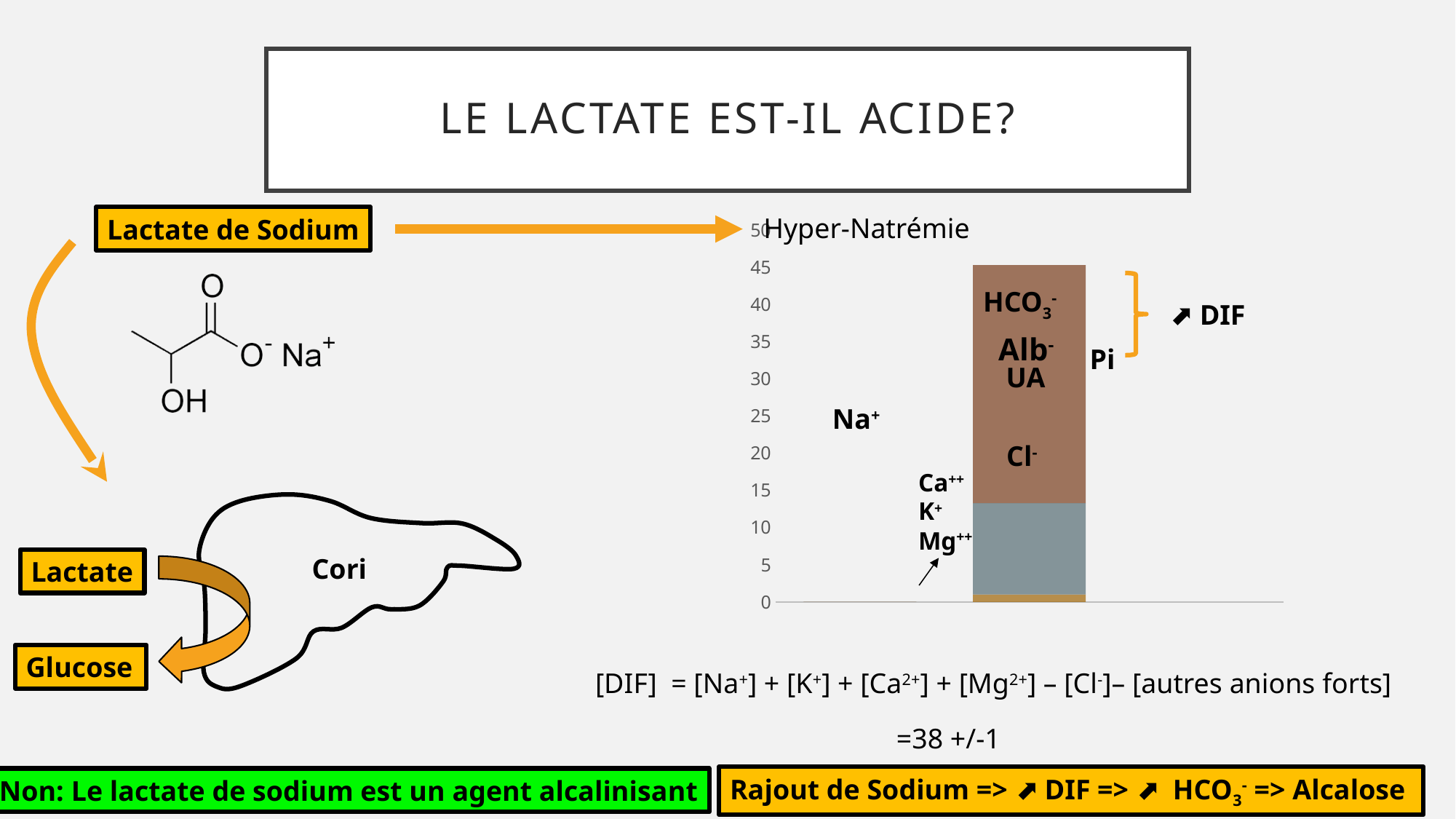
How many stacked segments make up the bar in the chart? 3 Is the top of the small bottom segment of the bar greater or less than 5? less What kind of chart is shown on the right side of the slide? bar chart Is the top of the grey-blue segment of the bar greater or less than 10? greater How many bars are plotted in the chart? 1 What colour is the largest segment of the stacked bar? brown What is the highest value shown on the chart's y axis? 50 Is the top of the stacked bar greater or less than 40 on the y axis? greater